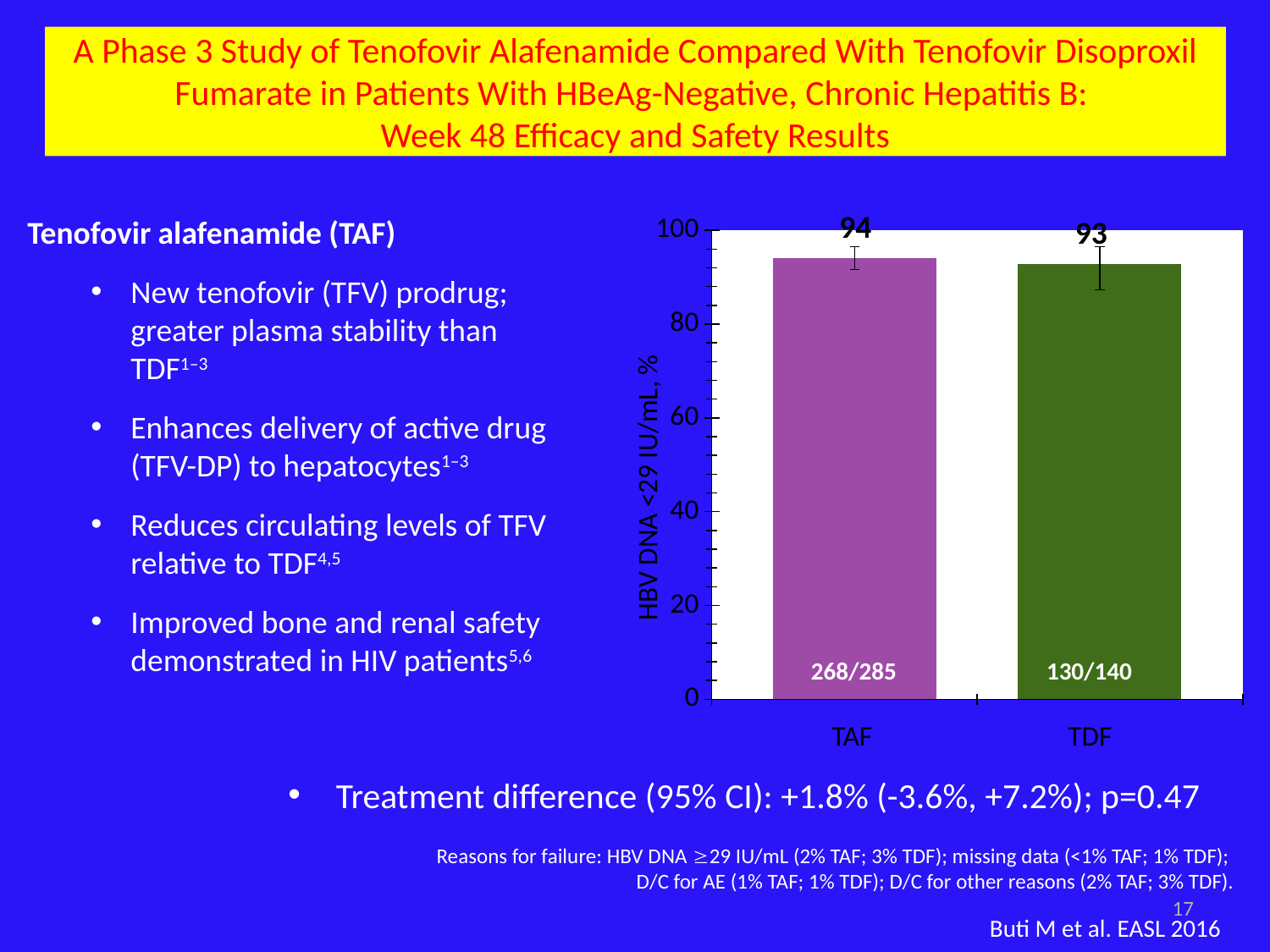
What fraction is printed inside the TDF bar? 130/140 What is the y-axis label of the chart? HBV DNA <29 IU/mL, % What type of chart is shown on the slide? Bar chart Is the value for TDF greater or less than 80? greater Which category has the lowest value in the chart? TDF What is the maximum value shown on the y axis? 100 What is the value for TAF in the bar chart? 94 What is the difference between the TAF and TDF values? 1 What fraction is printed inside the TAF bar? 268/285 Which category has the higher value, TAF or TDF? TAF What is the value for TDF in the bar chart? 93 How many bars are plotted in the chart? 2